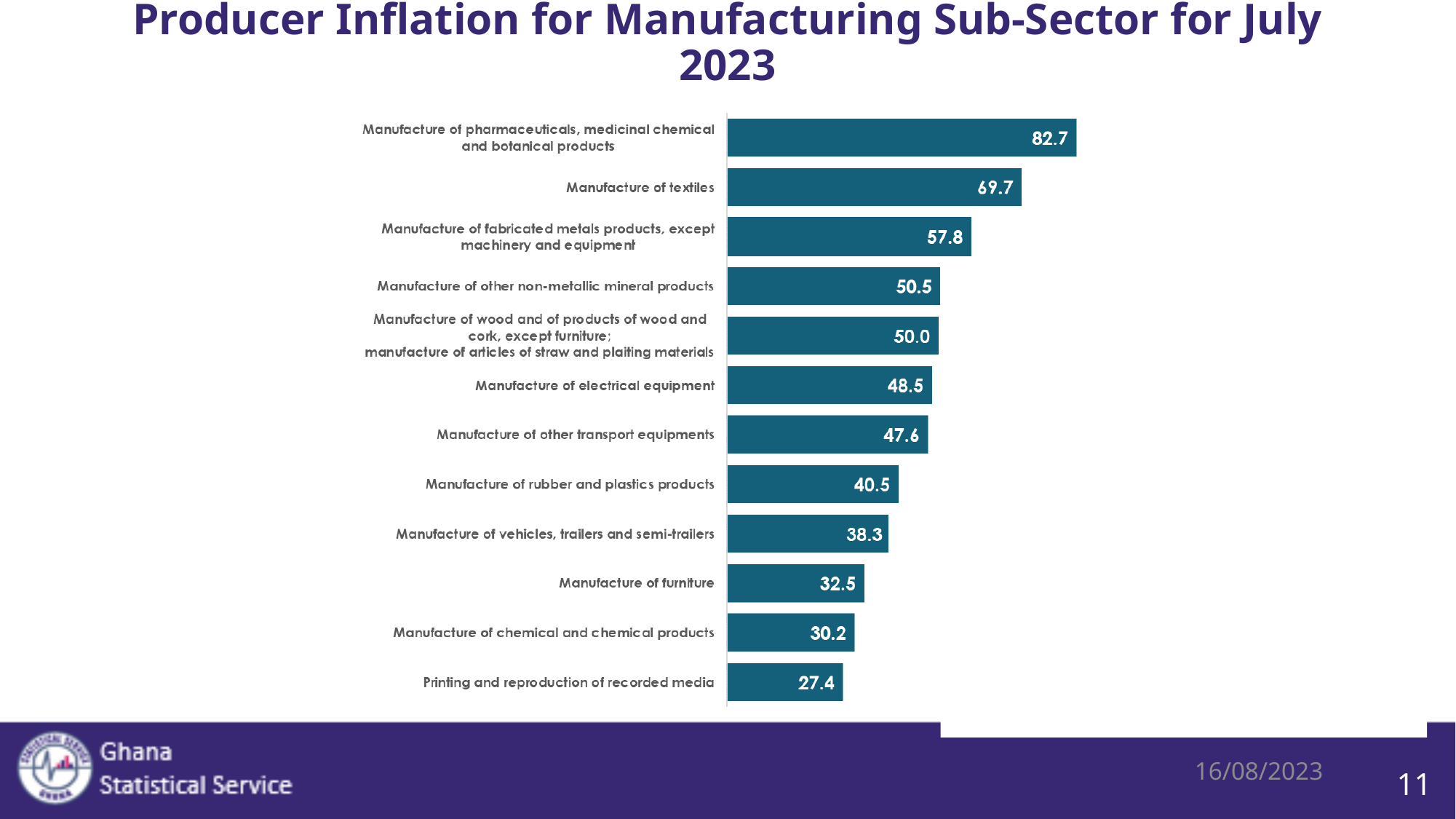
Which sub-sector has the lowest producer inflation? Printing and reproduction of recorded media How many sub-sectors are shown in the chart? 12 Which is larger: the value for Manufacture of electrical equipment or Manufacture of vehicles, trailers and semi-trailers? Manufacture of electrical equipment What kind of chart is shown on the slide? Bar chart What is the value shown for Manufacture of furniture? 32.5 Which sub-sector has the highest producer inflation? Manufacture of pharmaceuticals, medicinal chemical and botanical products What is the difference between the highest and lowest values in the chart? 55.3 What is the difference between the values for Manufacture of textiles and Manufacture of chemical and chemical products? 39.5 What is the value for Manufacture of rubber and plastics products? 40.5 What is the value for Manufacture of fabricated metals products, except machinery and equipment? 57.8 What is the producer inflation value for Manufacture of textiles? 69.7 What is the title of the chart on the slide? Producer Inflation for Manufacturing Sub-Sector for July 2023